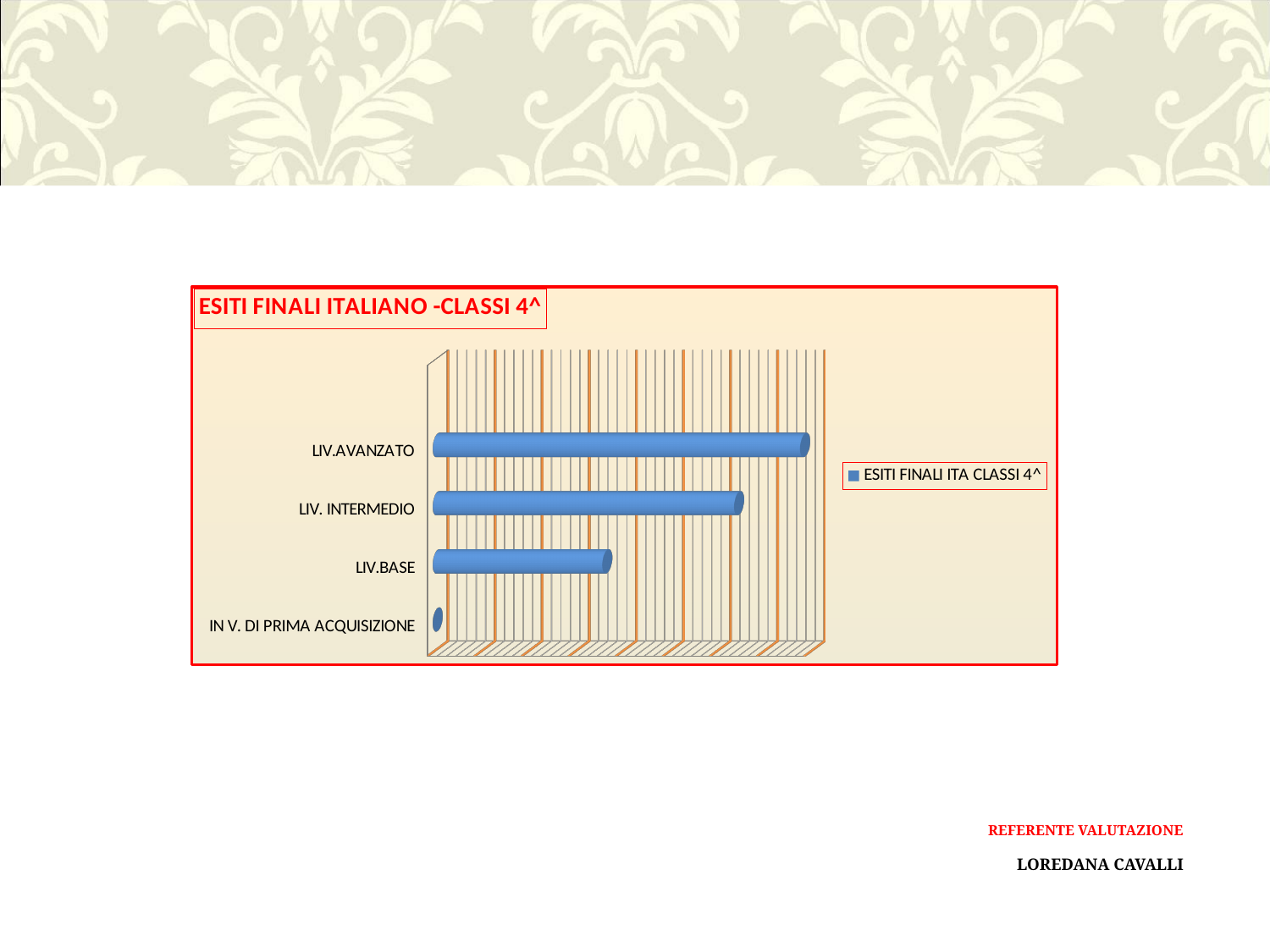
Which category has the second-longest bar? LIV. INTERMEDIO How many series does the legend list? 1 What is the name of the series shown in the legend? ESITI FINALI ITA CLASSI 4^ Which category has the longest bar? LIV.AVANZATO What kind of chart is shown on the slide? bar chart Which is larger, the bar for LIV.AVANZATO or the bar for LIV. INTERMEDIO? LIV.AVANZATO What is the title of the chart? ESITI FINALI ITALIANO -CLASSI 4^ Which is larger, the bar for LIV.BASE or the bar for IN V. DI PRIMA ACQUISIZIONE? LIV.BASE Which category has the shortest bar? IN V. DI PRIMA ACQUISIZIONE How many categories are shown on the chart? 4